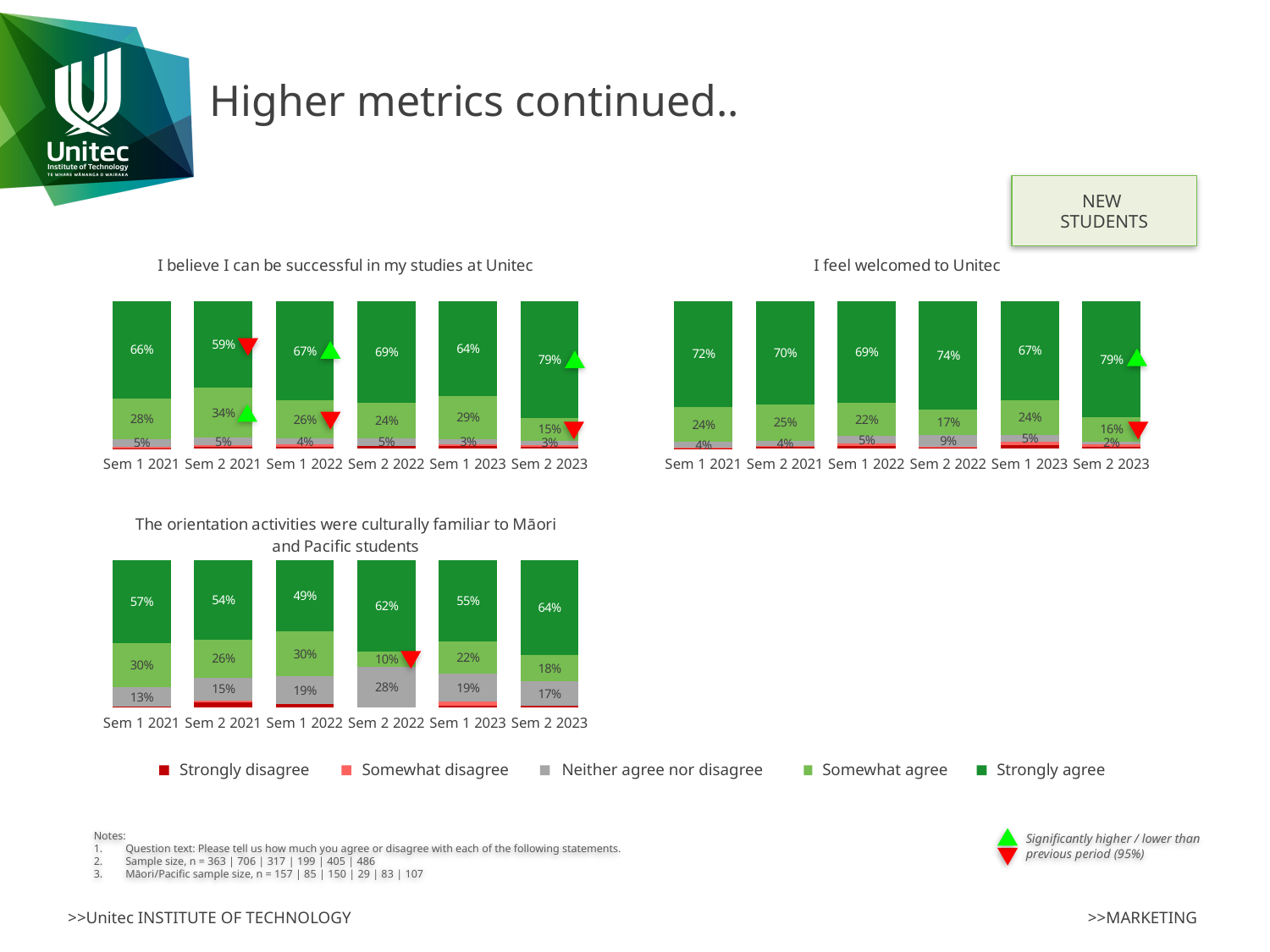
How many semesters are shown on the x axis of the chart 'I believe I can be successful in my studies at Unitec'? 6 In the chart 'I feel welcomed to Unitec', what is the Somewhat agree value for Sem 2 2022? 17% In the chart 'I feel welcomed to Unitec', which semester has the highest Strongly agree value? Sem 2 2023 In the chart 'I believe I can be successful in my studies at Unitec', which semester has the lowest Strongly agree value? Sem 2 2021 What kind of chart is 'I feel welcomed to Unitec'? Stacked bar chart In the chart 'I feel welcomed to Unitec', what is the difference between the Strongly agree values for Sem 2 2023 and Sem 1 2023? 12% In the chart 'The orientation activities were culturally familiar to Māori and Pacific students', is the Somewhat agree value larger for Sem 1 2021 or Sem 2 2022? Sem 1 2021 How many series does the legend on the slide list? 5 In the chart 'The orientation activities were culturally familiar to Māori and Pacific students', what is the Neither agree nor disagree value for Sem 2 2022? 28% In the chart 'The orientation activities were culturally familiar to Māori and Pacific students', which semester has the lowest Strongly agree value? Sem 1 2022 In the chart 'I believe I can be successful in my studies at Unitec', what is the Strongly agree value for Sem 2 2023? 79% Which legend entry is shown in dark green? Strongly agree